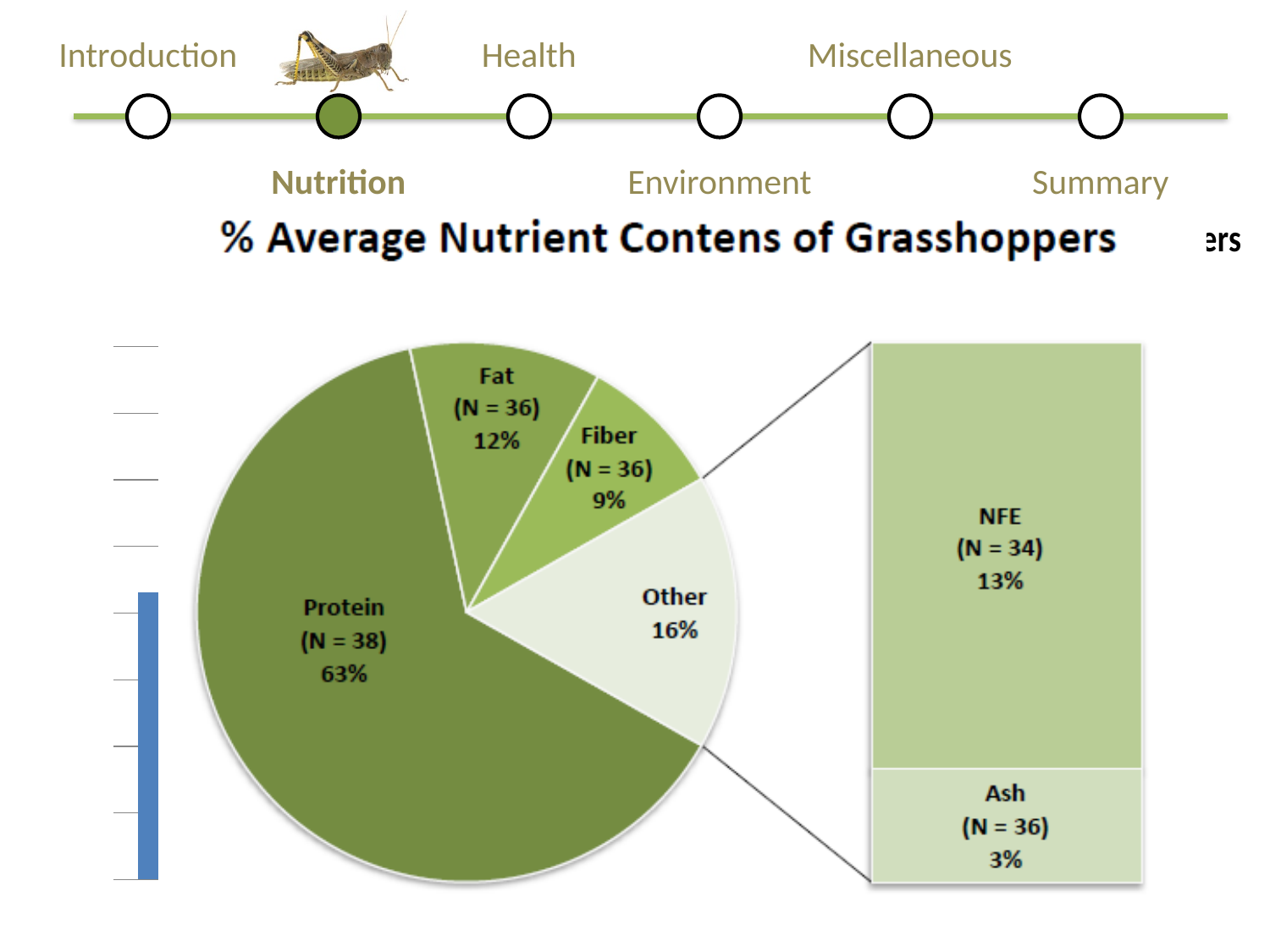
Which component in the breakout of the Other slice has the smallest share? Ash What is the sample size (N) shown for the Protein slice? N = 38 What percentage does Ash account for in the breakout of the Other slice? 3% What kind of chart is shown on the slide? pie chart What percentage of the pie chart is Protein? 63% What percentage does NFE account for in the breakout of the Other slice? 13% What is the title of the pie chart? % Average Nutrient Contens of Grasshoppers What percentage of the pie chart is Fiber? 9% Which nutrient has the largest slice of the pie chart? Protein What is the difference in percentage points between the Fat slice and the Fiber slice? 3% What percentage of the pie chart is Fat? 12% What percentage of the pie chart is labelled Other? 16%